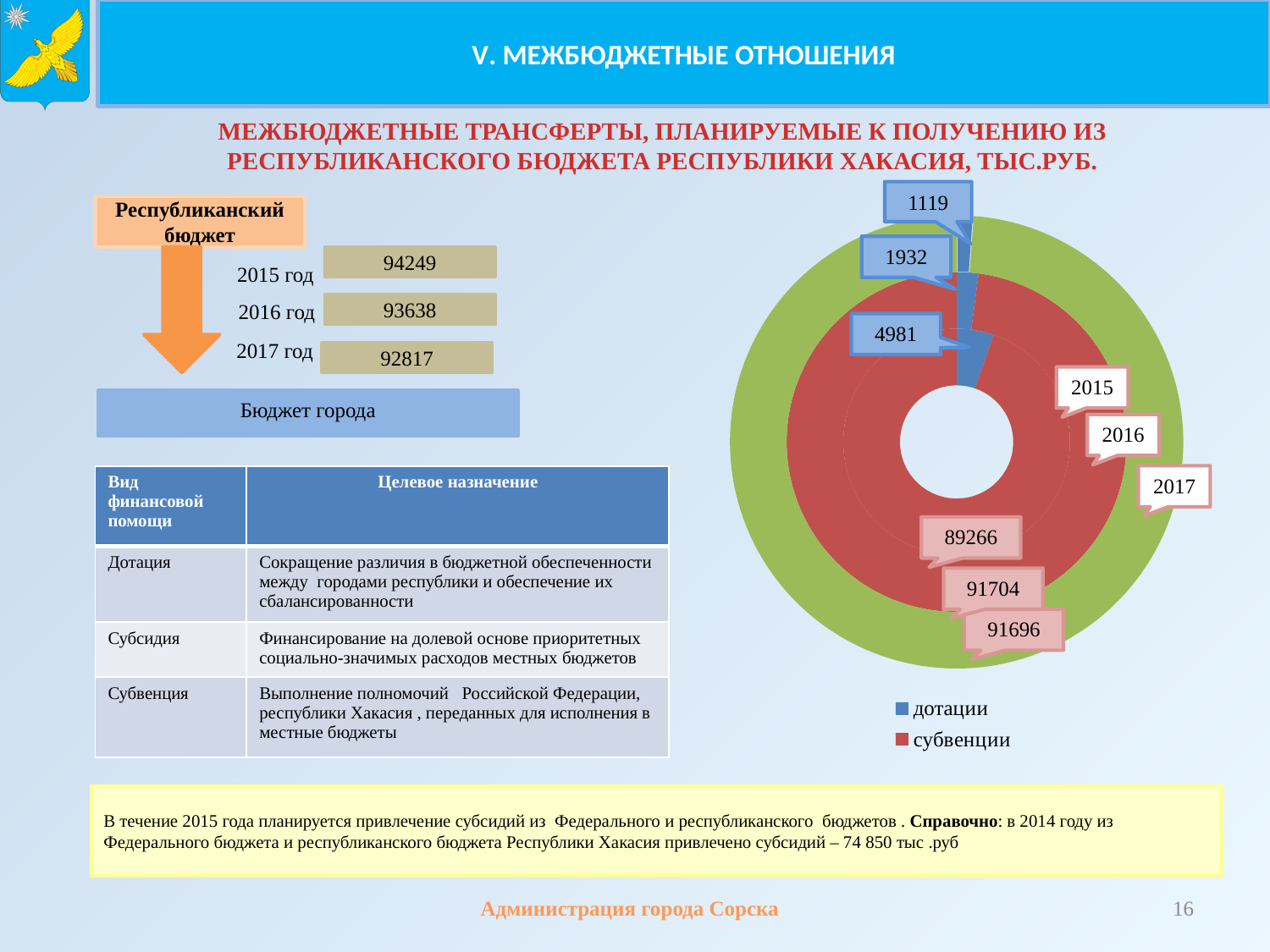
In the doughnut chart, which year has the lowest value of дотации? 2017 In the doughnut chart, which year has the highest value of дотации? 2015 In the doughnut chart, which is larger: дотации in 2016 or дотации in 2017? дотации in 2016 In the doughnut chart, what is the value of дотации for 2017? 1119 In the doughnut chart, do the values of дотации rise or fall from 2015 to 2017? fall In the doughnut chart, what is the difference between субвенции in 2016 and субвенции in 2015? 2438 Which series are listed in the legend of the doughnut chart? дотации, субвенции In the doughnut chart, what is the value of субвенции for 2016? 91704 In the doughnut chart, what is the value of субвенции for 2015? 89266 How many series does the legend of the doughnut chart list? 2 In the doughnut chart, what is the value of дотации for 2015? 4981 What kind of chart is shown on the right side of the slide? doughnut chart